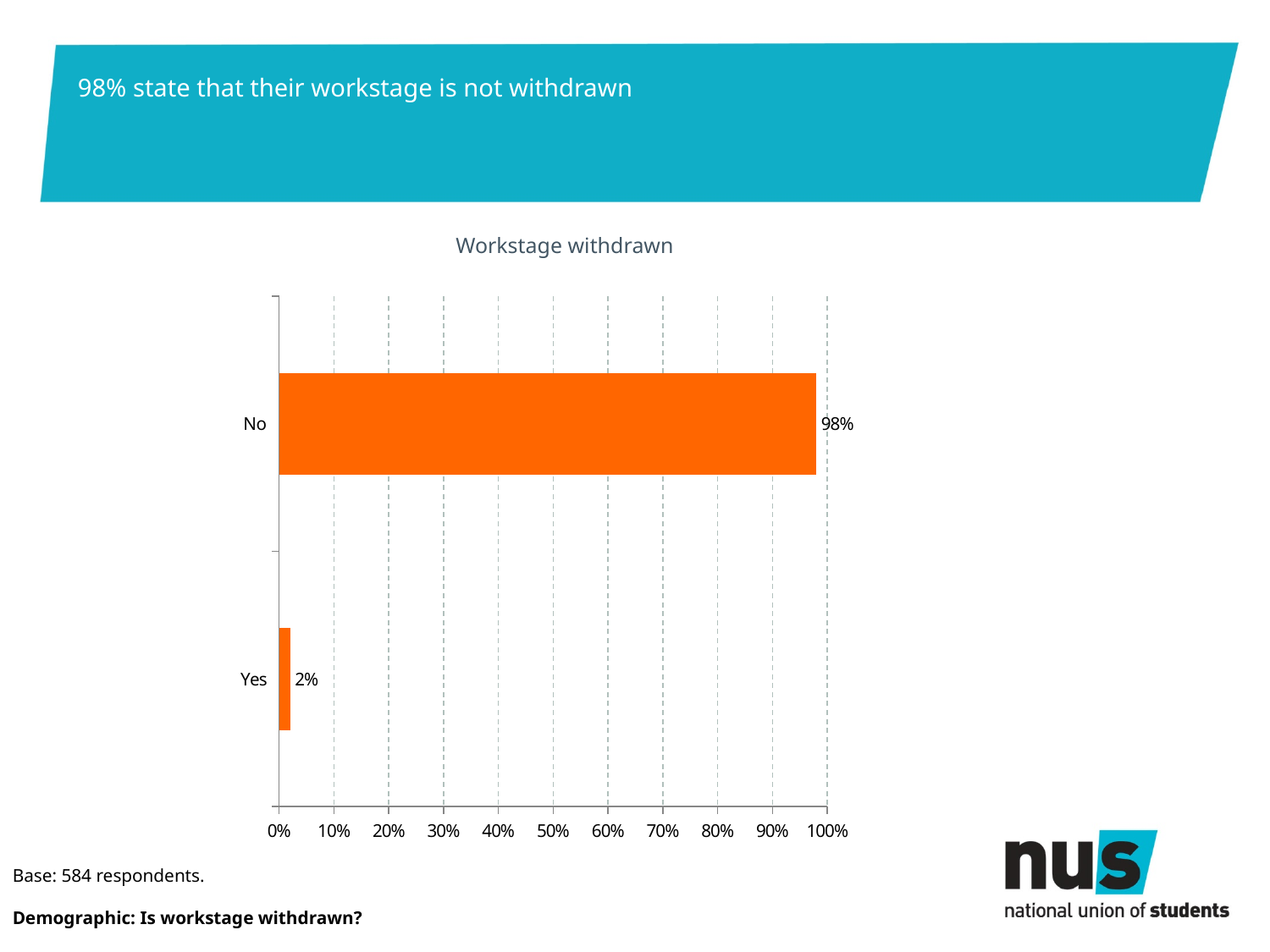
Which category has the lowest value? Yes What is the value for No? 98% How many categories are shown in the chart? 2 Is the value for Yes greater or less than 10%? less Which category has the highest value? No What is the difference between the values for No and Yes? 96 percentage points Is the value for No greater or less than 90%? greater What kind of chart is shown on the slide? bar chart Which is larger, the value for No or the value for Yes? No What is the value for Yes? 2% What colour are the bars in the chart? orange What is the title of the chart? Workstage withdrawn